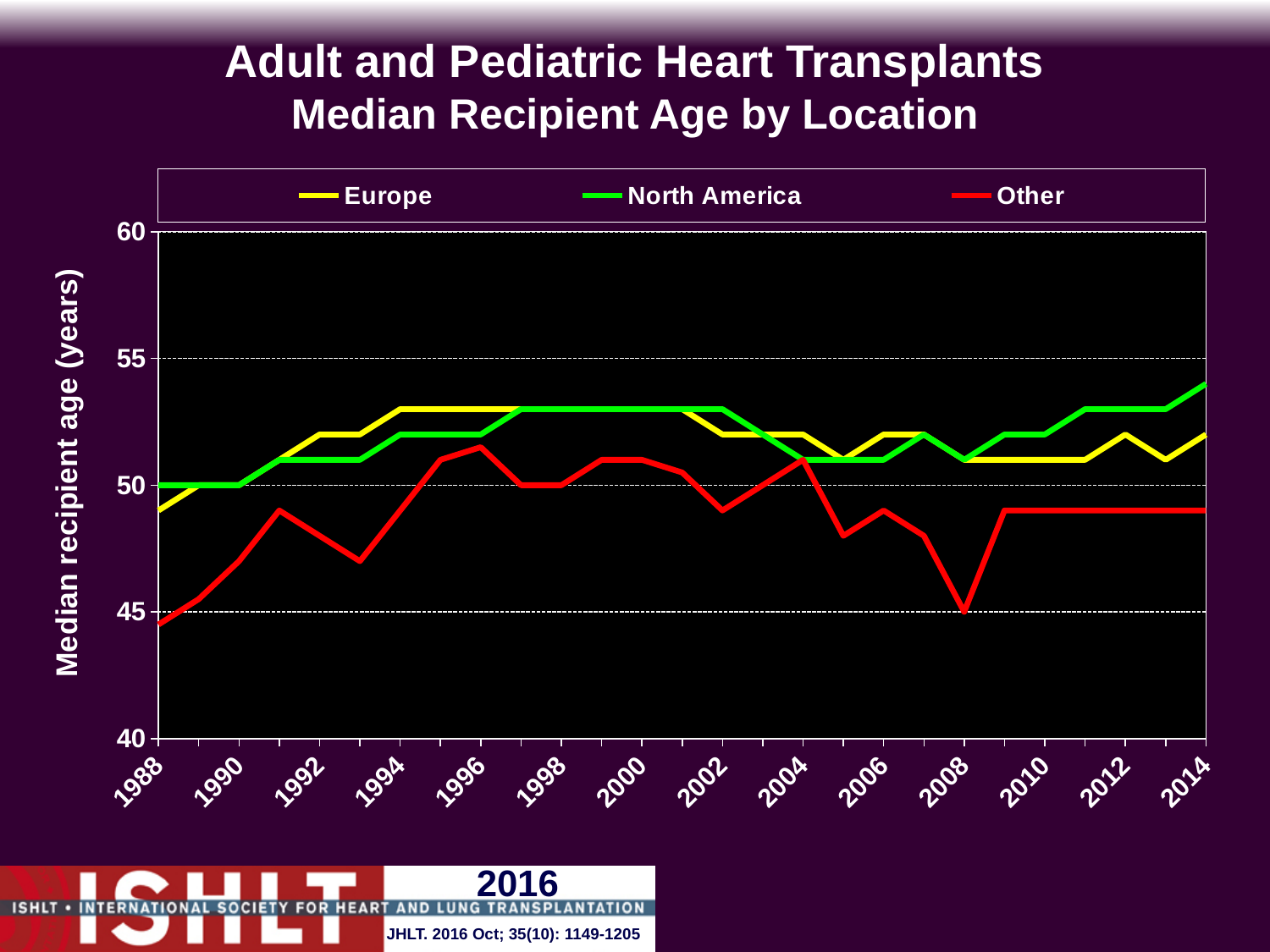
In which year is the Other series at its lowest? 1988 What is the label of the vertical axis? Median recipient age (years) Which series is drawn in red? Other How many series does the legend list? 3 What is the median recipient age for North America in 1988? 50 Does the Other series rise or fall from 2004 to 2008? fall What is the median recipient age for Other in 2008? 45 In which year is the North America series at its highest? 2014 Is the value for Other in 2010 greater or less than 50? less Is the value for North America in 2014 greater or less than 55? less What kind of chart is shown on the slide? line chart In 2008, which is larger, the value for North America or the value for Other? North America